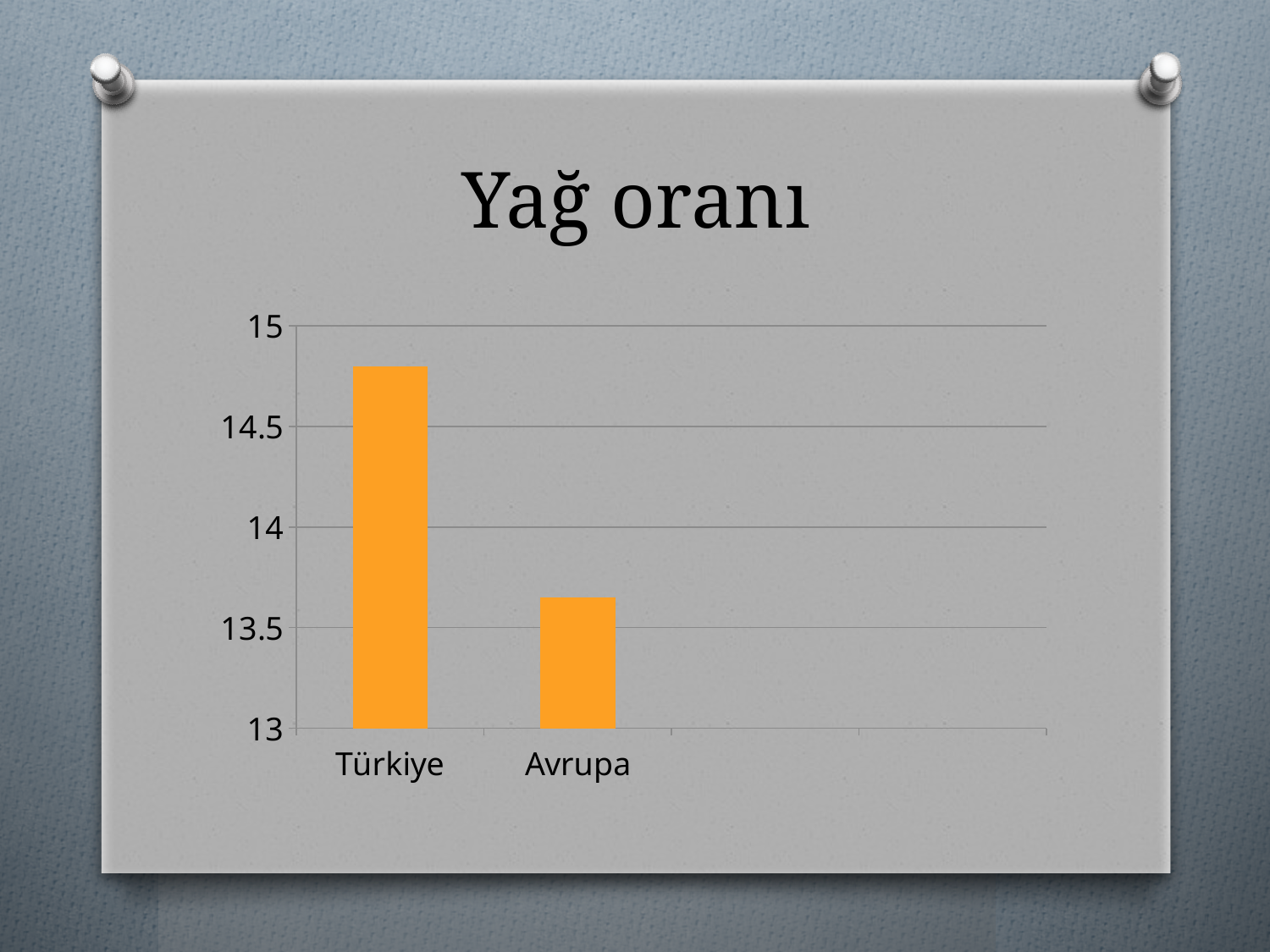
Is the value for Avrupa greater or less than 13.5? greater How many categories are shown on the x axis of the chart? 2 What kind of chart is shown on the slide? bar chart Is the value for Avrupa greater or less than 14? less Which category has the highest value in the chart? Türkiye What is the title of the chart? Yağ oranı Do the values rise or fall from Türkiye to Avrupa along the x axis? fall Which is larger, the value for Türkiye or the value for Avrupa? Türkiye Which category has the lowest value in the chart? Avrupa Is the value for Türkiye greater or less than 14.5? greater What colour are the bars in the chart? orange